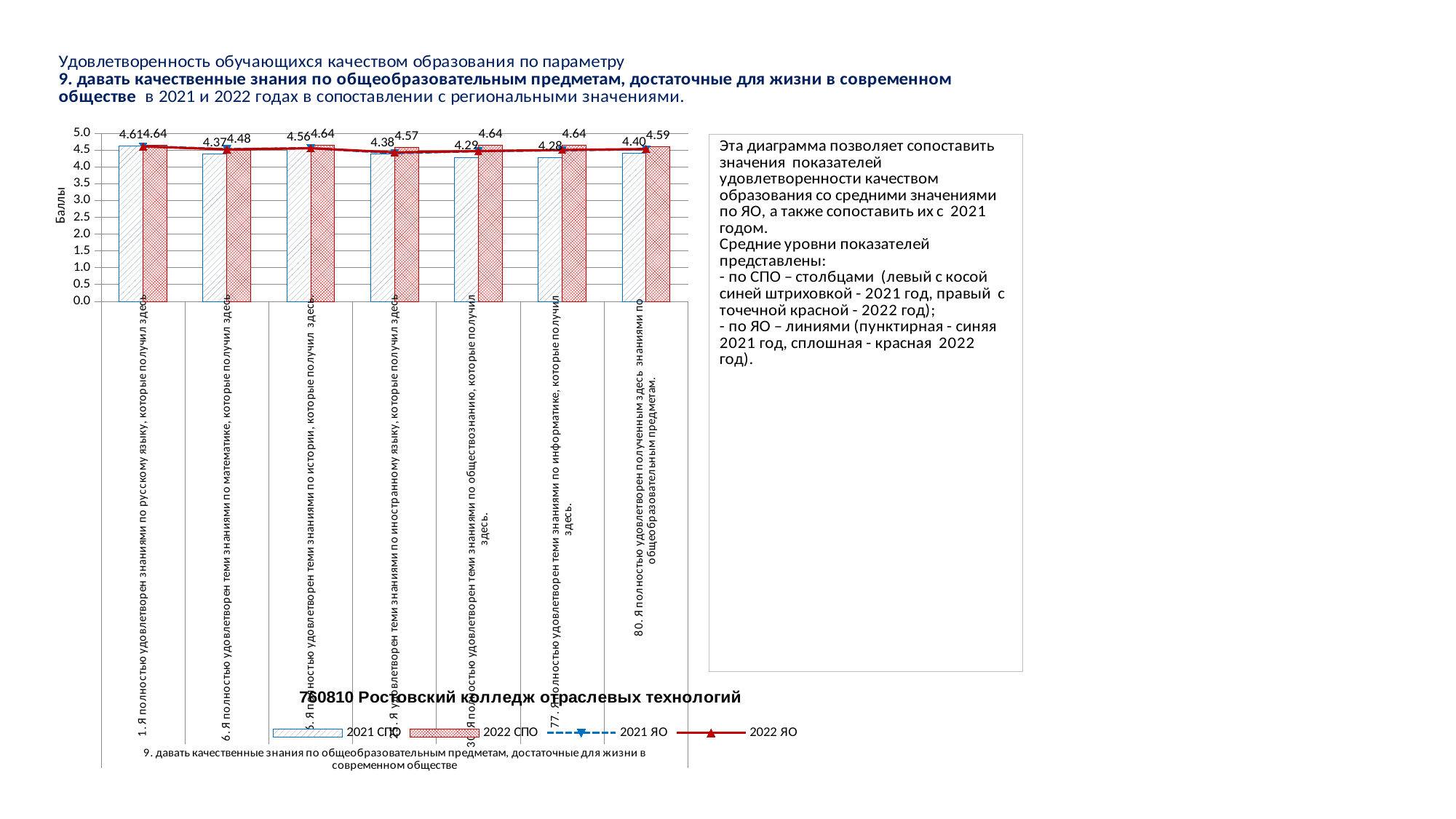
Which category has the lowest 2021 СПО value? 77. Я полностью удовлетворен теми знаниями по информатике (4.28) What is the 2022 СПО value for category 80 (knowledge of general education subjects, общеобразовательным предметам)? 4.59 What kind of chart is shown on the slide? Bar chart combined with line series What is the 2021 СПО value for the category about knowledge of informatics (информатике)? 4.28 How many series does the chart legend list? 4 What is the 2022 СПО value for the category about knowledge of mathematics (математике)? 4.48 What is the difference between the 2022 СПО and 2021 СПО values for the category about mathematics (математике)? 0.11 Which category has the highest 2021 СПО value? 1. Я полностью удовлетворен знаниями по русскому языку (4.61) What is the 2021 СПО value for the category about knowledge of Russian language (русскому языку)? 4.61 What is the difference between the 2022 СПО and 2021 СПО values for the category about social studies (обществознанию)? 0.35 Which is larger: the 2021 СПО value for history (истории) or for foreign language (иностранному языку)? истории (4.56) How many categories are shown on the x axis of the chart? 7